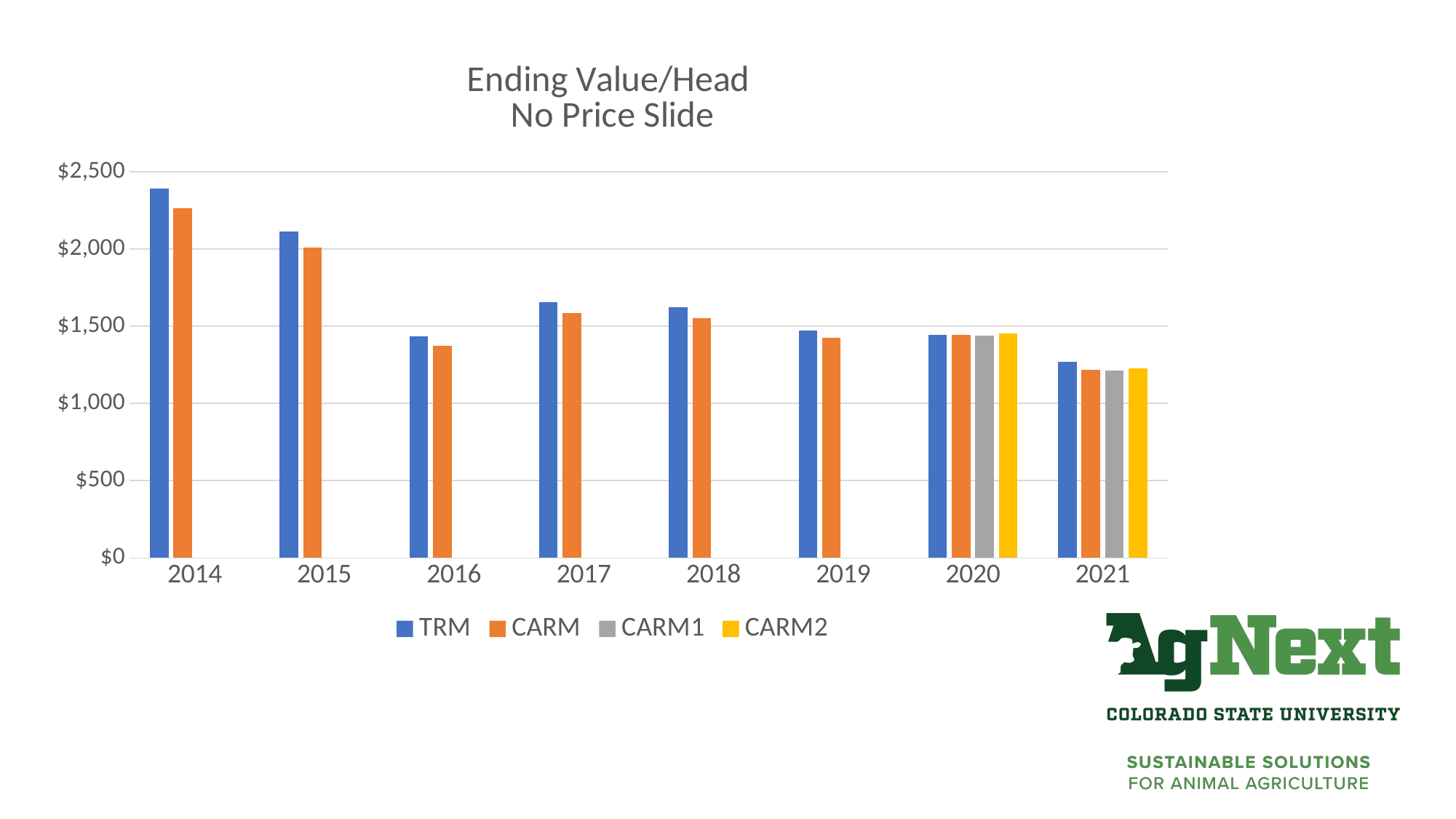
Do the TRM values rise or fall from 2014 to 2016? fall In which year is the TRM value lowest? 2021 Which is larger, the TRM value for 2017 or the TRM value for 2016? 2017 In which year is the TRM value highest? 2014 Which series is shown in yellow in the legend? CARM2 In 2014, which is larger, the TRM value or the CARM value? TRM How many series does the legend list? 4 Is the TRM value for 2014 greater or less than $2,000? greater What kind of chart is shown on the slide? bar chart How many years are shown on the x axis? 8 Is the CARM value for 2014 greater or less than $2,000? greater Is the CARM value for 2016 greater or less than $1,500? less